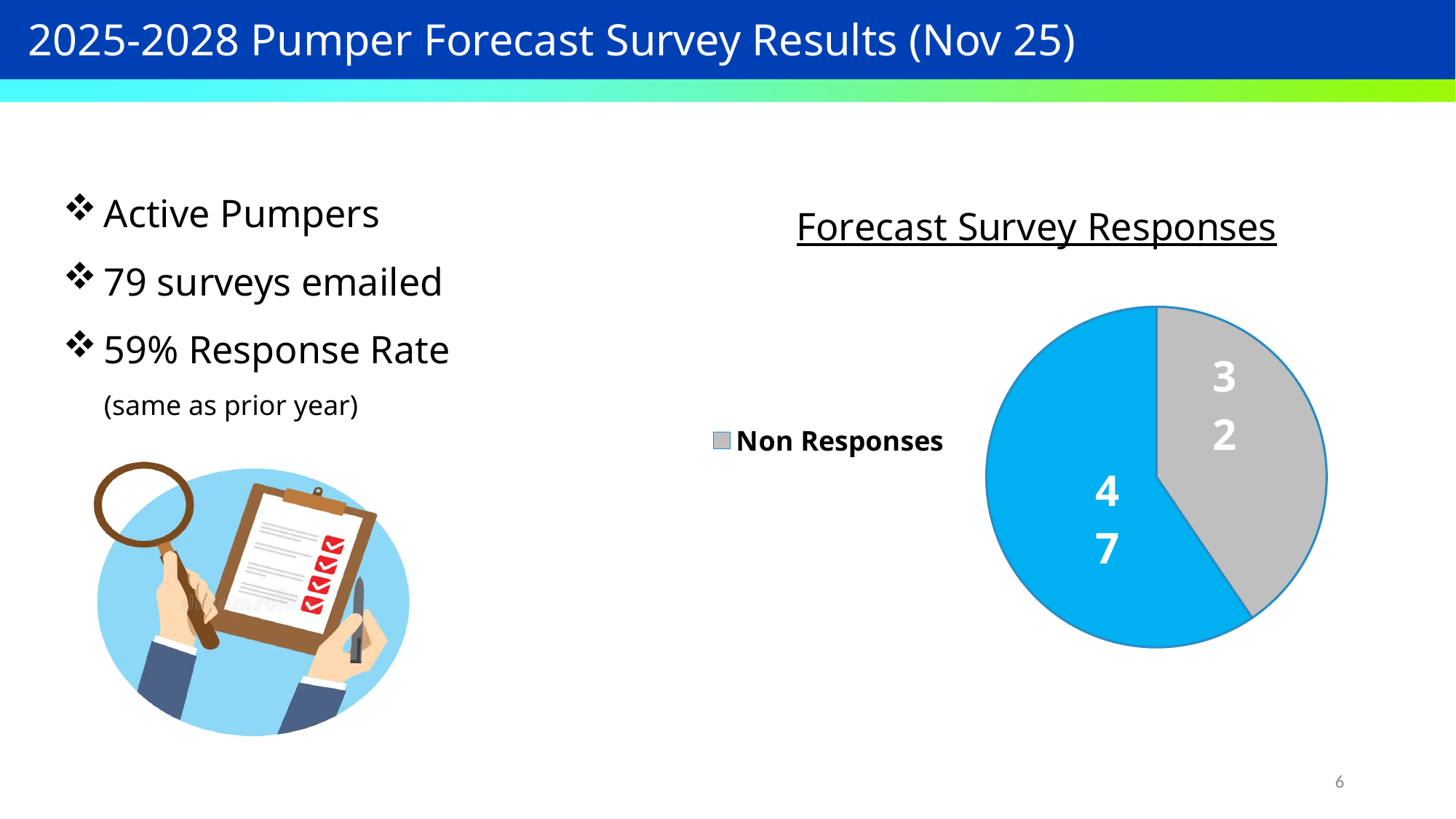
What is the title of the chart on the slide? Forecast Survey Responses What is the total of the two slice values in the pie chart? 79 What value is shown on the Non Responses slice of the pie chart? 32 Which slice of the pie chart is larger, the blue slice or the gray Non Responses slice? the blue slice What kind of chart is shown under the title "Forecast Survey Responses"? pie chart What value is shown on the blue slice of the pie chart? 47 How many entries does the legend of the pie chart list? 1 What colour is the Non Responses slice in the pie chart? gray What is the difference between the blue slice value and the Non Responses slice value in the pie chart? 15 Is the value of the Non Responses slice greater or less than 40? less How many slices does the pie chart have? 2